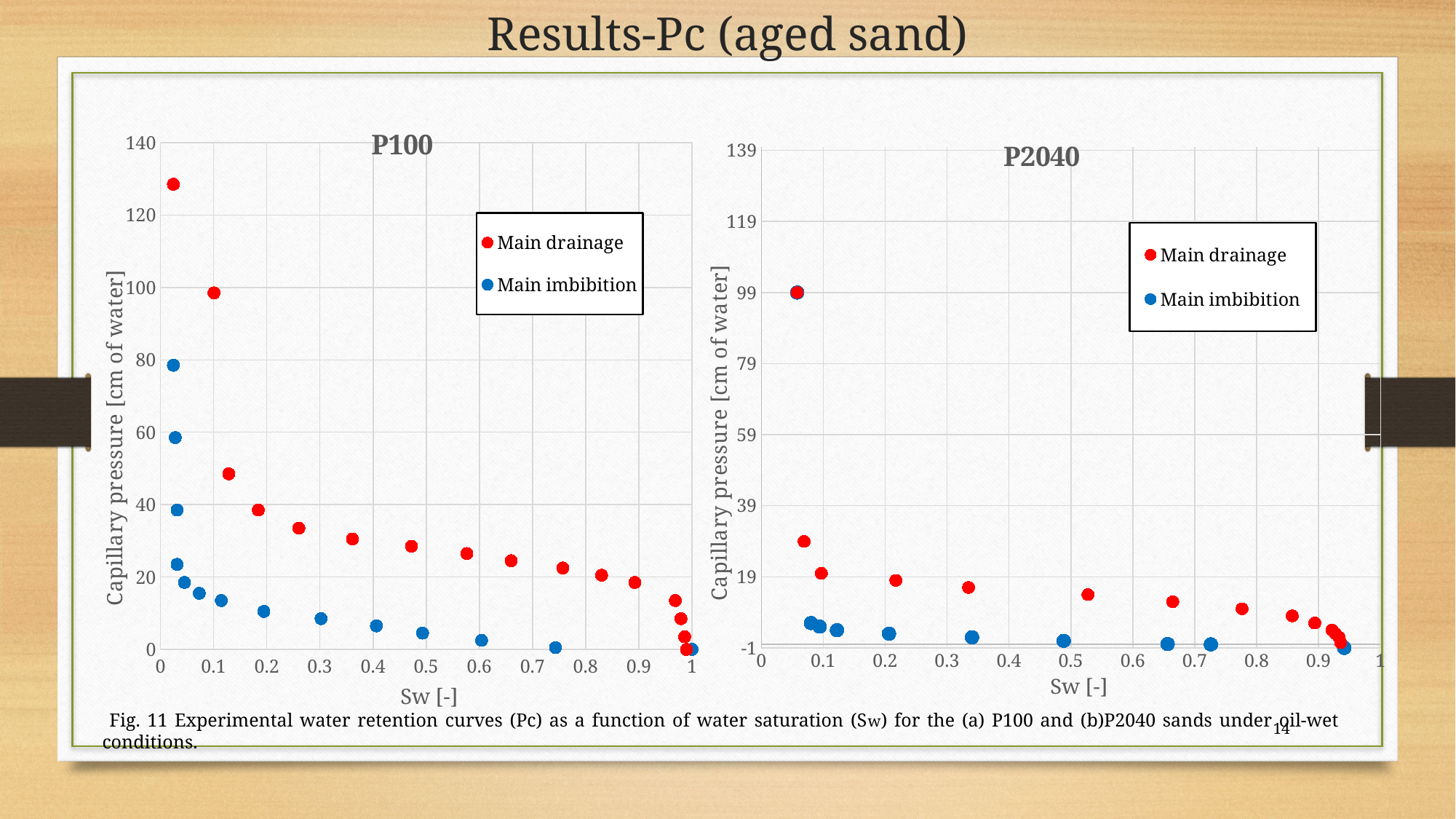
What kind of chart is the P100 chart? scatter chart In the P2040 chart, is the Main drainage value at Sw of about 0.5 greater or less than 39? less In the P100 chart, do the Main drainage values rise or fall as Sw increases? fall In the P2040 chart, do the Main imbibition values rise or fall as Sw increases? fall In the P2040 chart, at Sw of about 0.2, which series has the larger value, Main drainage or Main imbibition? Main drainage What is the y-axis label of the P2040 chart? Capillary pressure [cm of water] In the P100 chart, which series reaches the higher capillary pressure, Main drainage or Main imbibition? Main drainage How many series does the legend of the P2040 chart list? 2 In the P100 chart, what are the two series named in the legend? Main drainage and Main imbibition In the P2040 chart, is the highest Main drainage value greater or less than 79? greater In the P100 chart, is the highest Main imbibition value greater or less than 60? greater